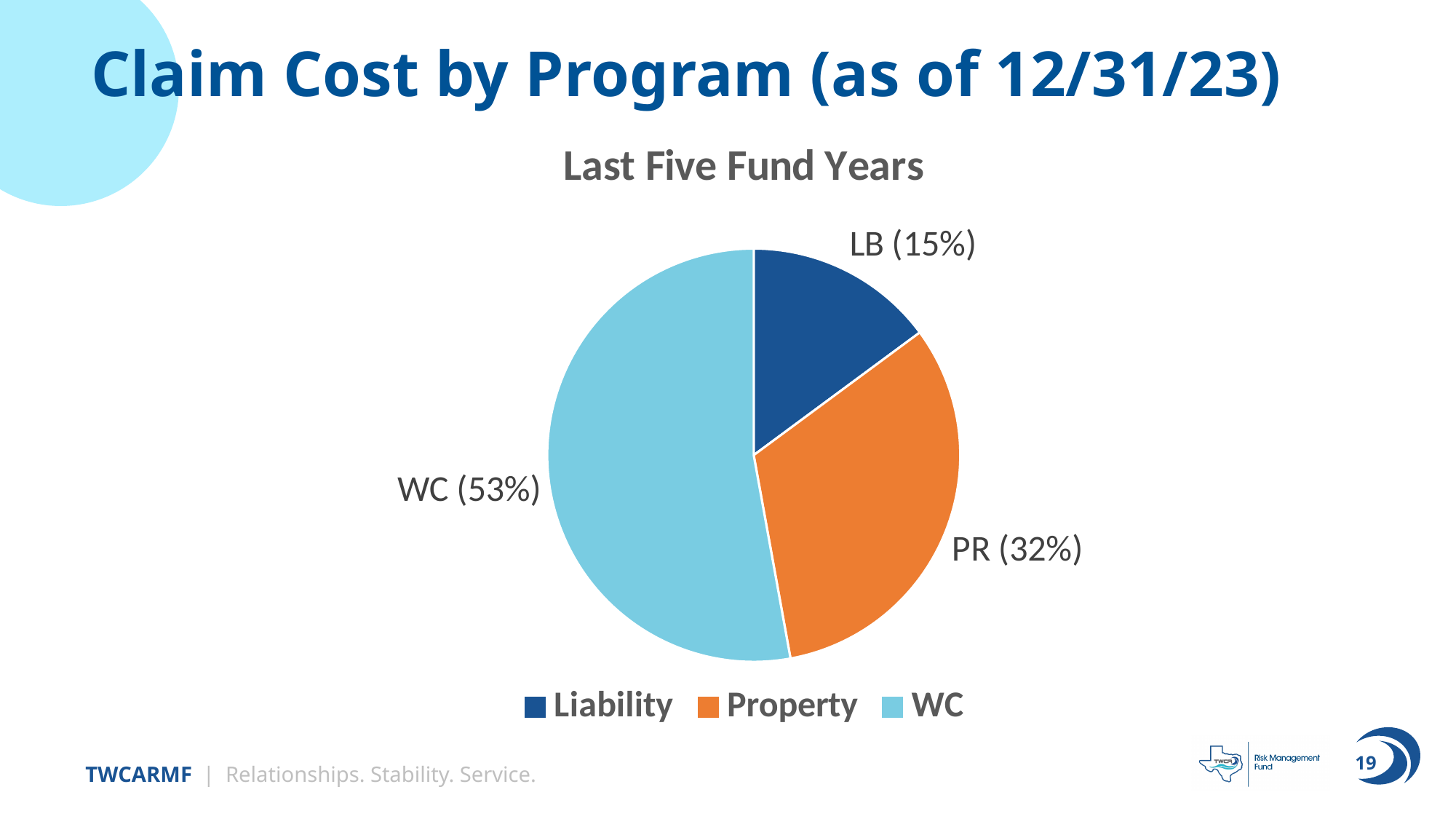
What share of claim cost does PR (Property) account for? 32% Which program has the smallest share of claim cost? LB (Liability) What is the title of the chart? Last Five Fund Years What colour is the WC slice in the pie chart? Light blue Which is larger, the Property share or the Liability share? Property What kind of chart is shown on the slide? Pie chart Which program has the largest share of claim cost? WC What share of claim cost does WC account for? 53% What share of claim cost does LB (Liability) account for? 15% How many slices does the pie chart have? 3 What is the difference in percentage points between the WC share and the PR share? 21 What is the difference in percentage points between the PR share and the LB share? 17